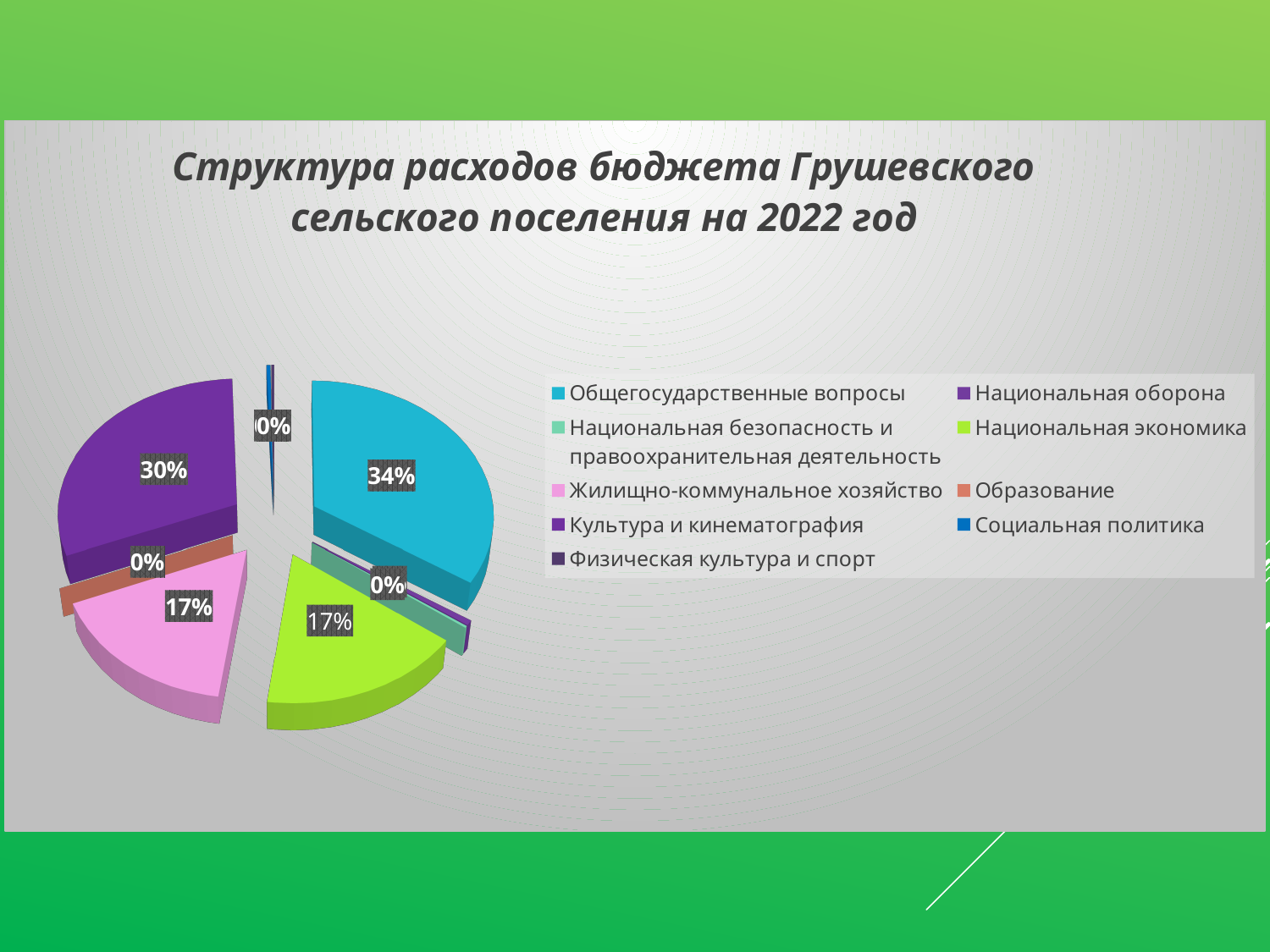
What percentage is shown for Культура и кинематография? 30% What percentage is shown for Образование? 0% How many categories does the legend list? 9 What is the title of the chart? Структура расходов бюджета Грушевского сельского поселения на 2022 год What type of chart is shown on the slide? Pie chart What colour is the slice for Общегосударственные вопросы? Light blue (cyan) Which category has the largest share of the pie? Общегосударственные вопросы What percentage is shown for Жилищно-коммунальное хозяйство? 17% Which is larger: the share for Культура и кинематография or for Национальная экономика? Культура и кинематография What percentage is shown for Национальная экономика? 17% By how many percentage points does Общегосударственные вопросы exceed Культура и кинематография? 4 percentage points What share of the budget expenditure is labelled for Общегосударственные вопросы? 34%